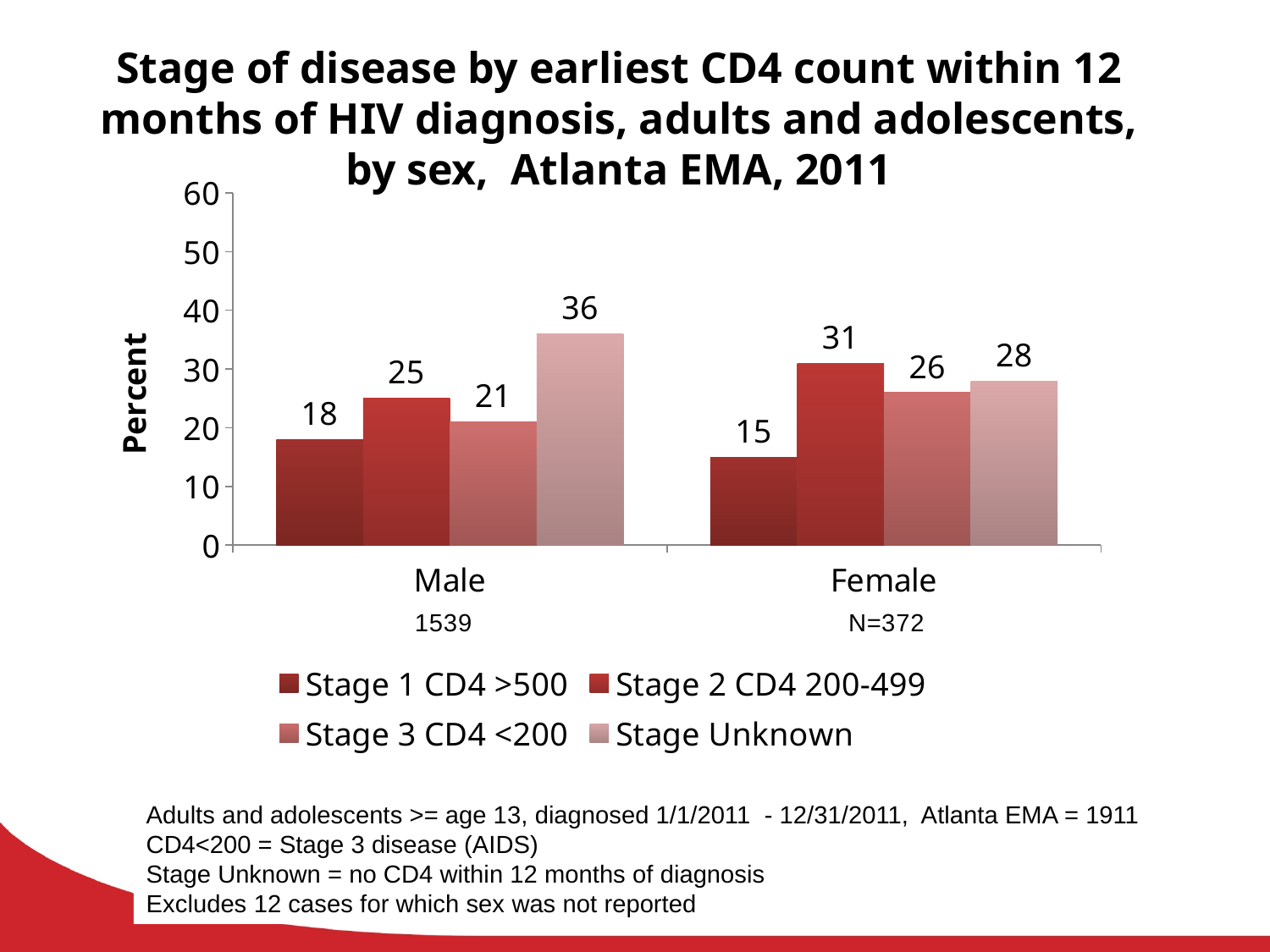
Is the value for Stage 3 CD4 <200 for Male greater or less than 30? less What is the label of the y axis? Percent What is the difference between the Stage Unknown values for Male and Female? 8 What is the value for Stage 1 CD4 >500 for Male? 18 Which series has the lowest value for Female? Stage 1 CD4 >500 How many categories are shown on the x axis? 2 How many series does the legend list? 4 Which is larger, the Stage 2 CD4 200-499 value for Male or for Female? Female What kind of chart is shown on the slide? bar chart What is the value for Stage Unknown for Female? 28 Which series has the highest value for Male? Stage Unknown What is the value for Stage 2 CD4 200-499 for Female? 31